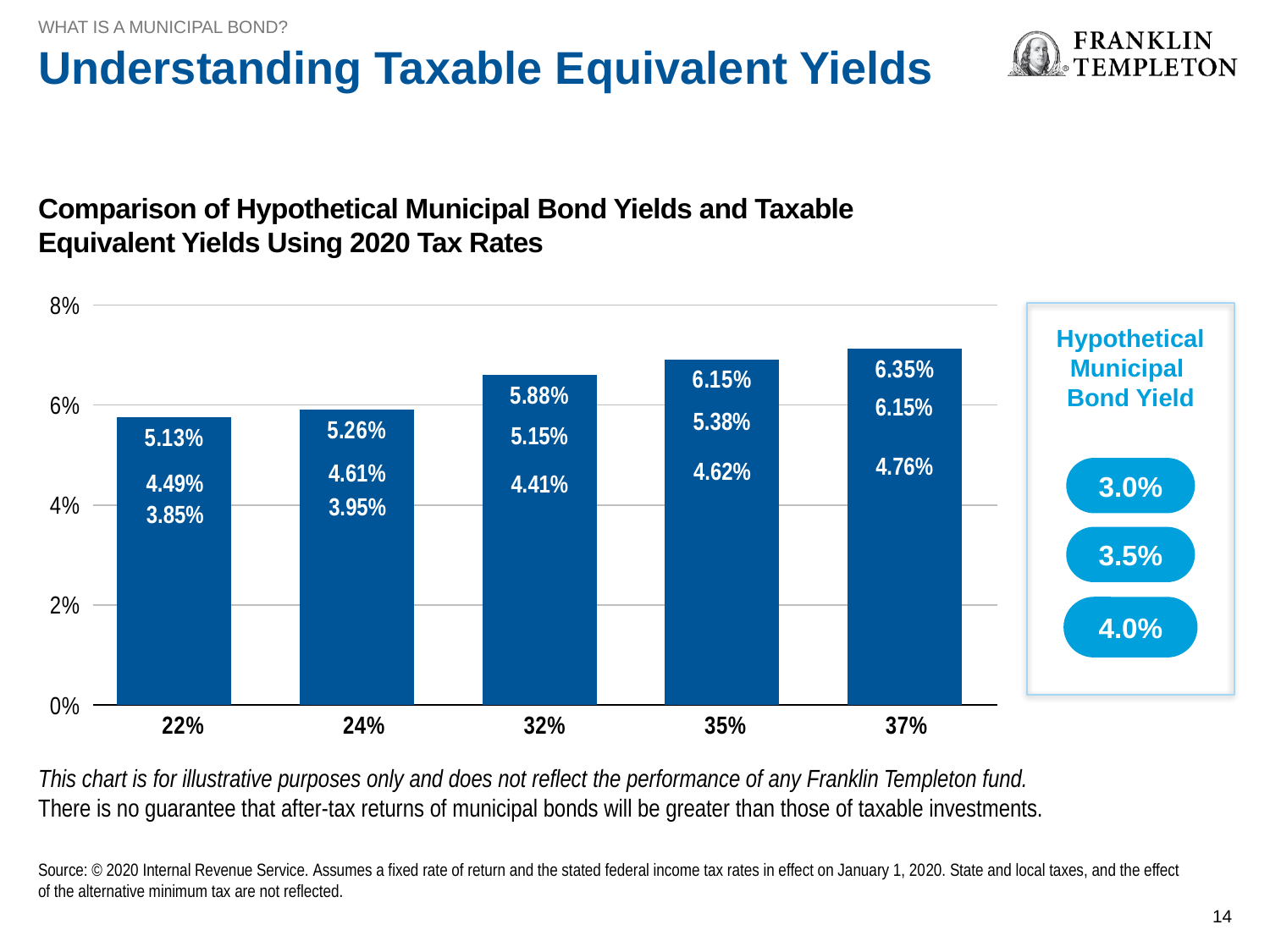
How many tax rate categories are shown on the x axis of the chart? 5 What is the middle value labeled on the bar for the 32% tax rate? 5.15% Is the height of the bar for the 37% tax rate greater or less than 6%? greater What kind of chart is shown on the slide? Bar chart Which tax rate has the shortest bar in the chart? 22% What is the lowest taxable equivalent yield labeled on the bar for the 22% tax rate? 3.85% Do the bar heights rise or fall as the tax rate increases from 22% to 37%? Rise What is the difference between the top value on the 37% bar (6.35%) and the top value on the 22% bar (5.13%)? 1.22 percentage points How many hypothetical municipal bond yields are listed in the legend box to the right of the chart? 3 Which is larger: the top value on the 32% bar or the top value on the 35% bar? 35% What is the highest taxable equivalent yield labeled on the bar for the 37% tax rate? 6.35% Which tax rate has the tallest bar in the chart? 37%